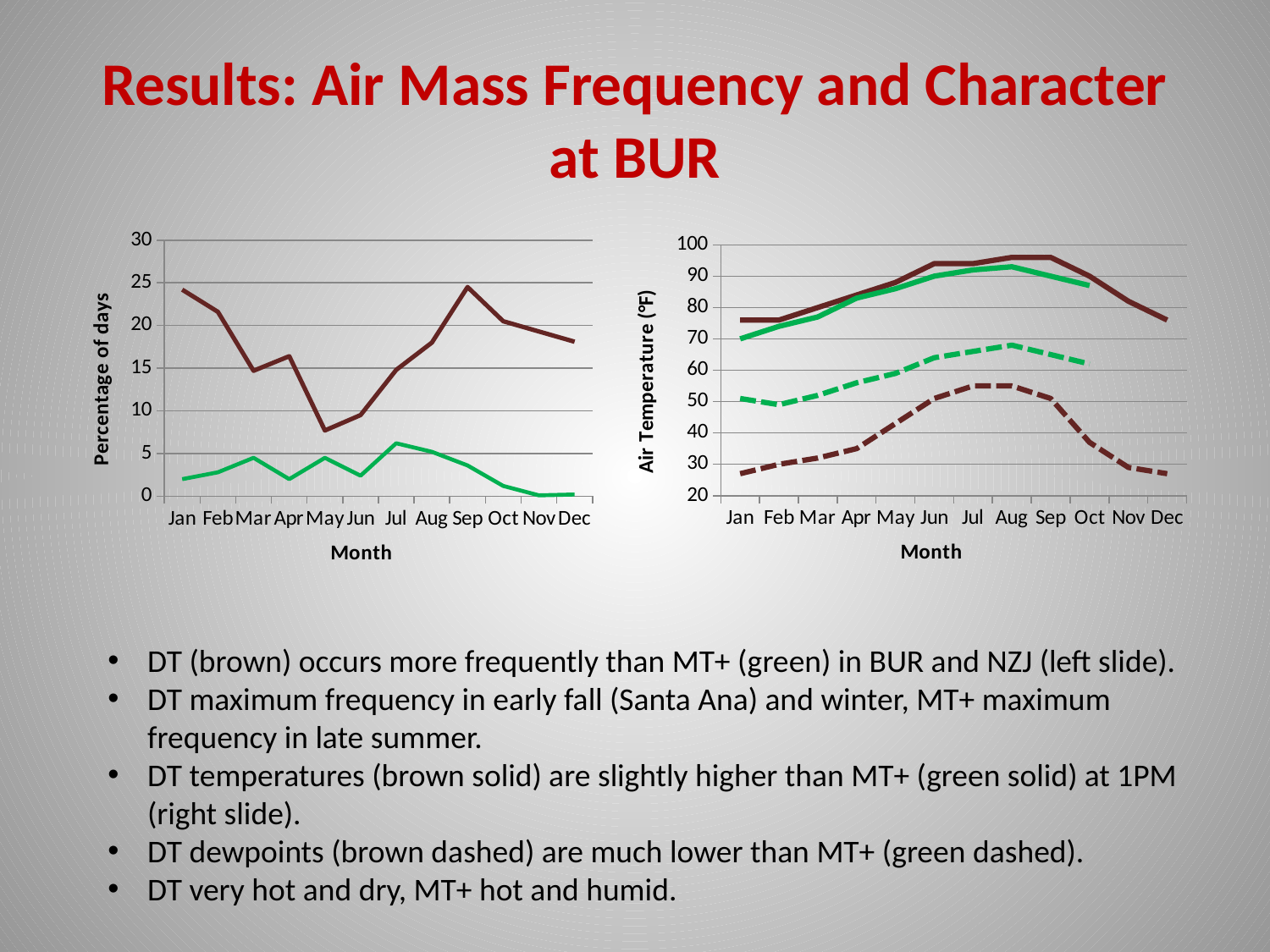
In the left chart (Percentage of days), is the brown line's value for May greater or less than 10? less In the right chart (Air Temperature), in which month is the brown dashed line at its lowest? Jan and Dec In the left chart (Percentage of days), in which month does the green line reach its highest value? Jul How many months are shown on the x axis of the right chart (Air Temperature)? 12 In the left chart (Percentage of days), which line is higher in Jan, the brown line or the green line? brown In the right chart (Air Temperature), is the green dashed line's value for Aug greater or less than 60? greater What kind of chart is the left chart (Percentage of days)? line chart In the right chart (Air Temperature), does the brown solid line rise or fall from Jan to Aug? rise What is the y-axis label of the right chart? Air Temperature (°F) In the right chart (Air Temperature), is the brown dashed line's value for Jan greater or less than 30? less In the left chart (Percentage of days), in which month is the brown line at its lowest? May